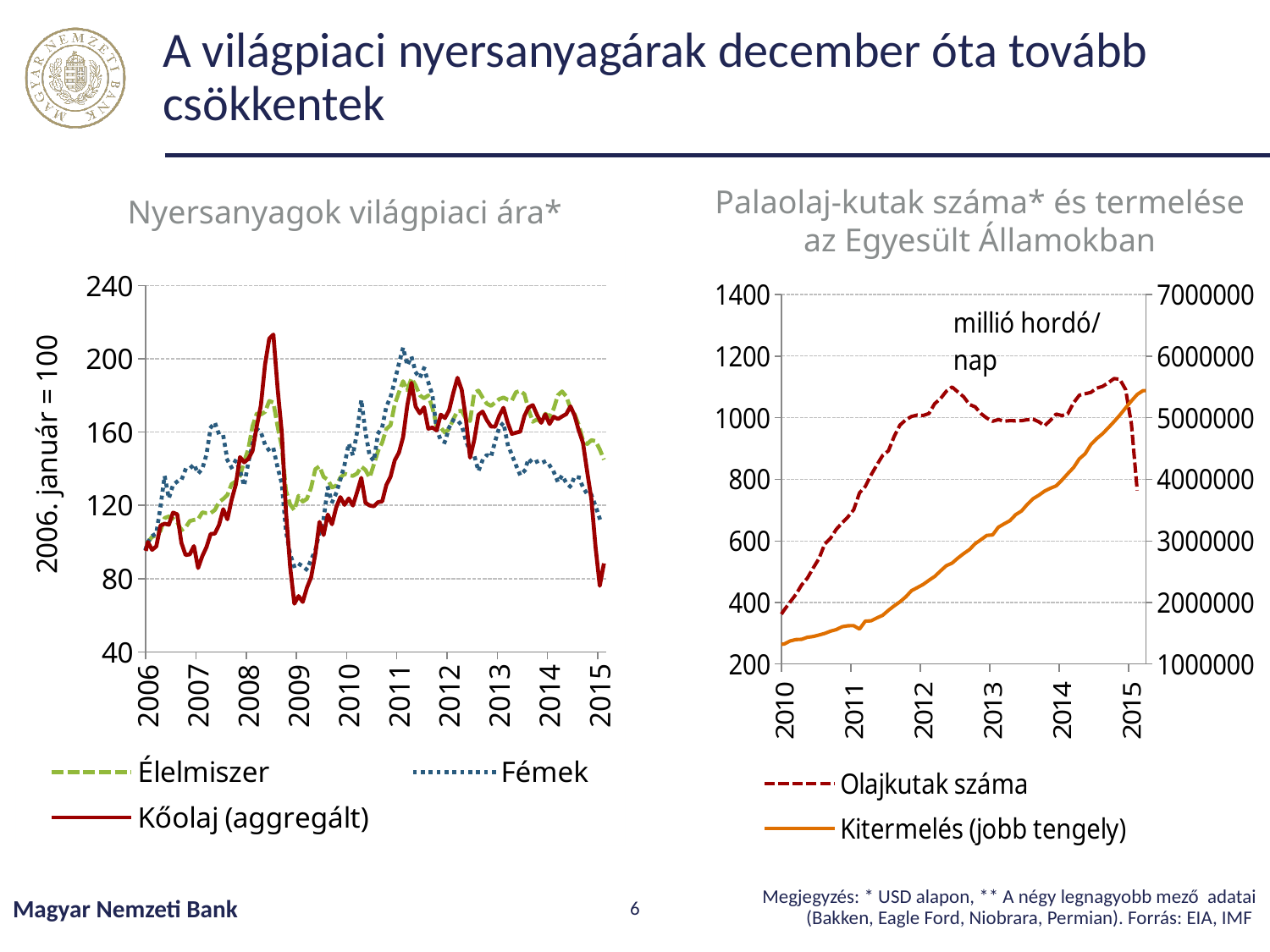
How many series does the legend of the right chart "Palaolaj-kutak száma* és termelése az Egyesült Államokban" list? 2 In the left chart "Nyersanyagok világpiaci ára*", which series is drawn as a solid red line? Kőolaj (aggregált) In the left chart "Nyersanyagok világpiaci ára*", at the 2011 peak, which is higher: Fémek or Kőolaj (aggregált)? Fémek In the right chart, which series is plotted on the right axis according to the legend? Kitermelés (jobb tengely) In the left chart "Nyersanyagok világpiaci ára*", is the peak value of Kőolaj (aggregált) in 2008 greater or less than 200? greater In the left chart "Nyersanyagok világpiaci ára*", is the lowest value of Kőolaj (aggregált) in early 2009 greater or less than 80? less In the right chart, does Kitermelés (jobb tengely) generally rise or fall from 2010 to 2015? rise What kind of chart is the right chart titled "Palaolaj-kutak száma* és termelése az Egyesült Államokban"? line chart How many series does the legend of the left chart "Nyersanyagok világpiaci ára*" list? 3 In the right chart, is the value of Olajkutak száma at the start of 2010 greater or less than 400? less What kind of chart is the left chart titled "Nyersanyagok világpiaci ára*"? line chart